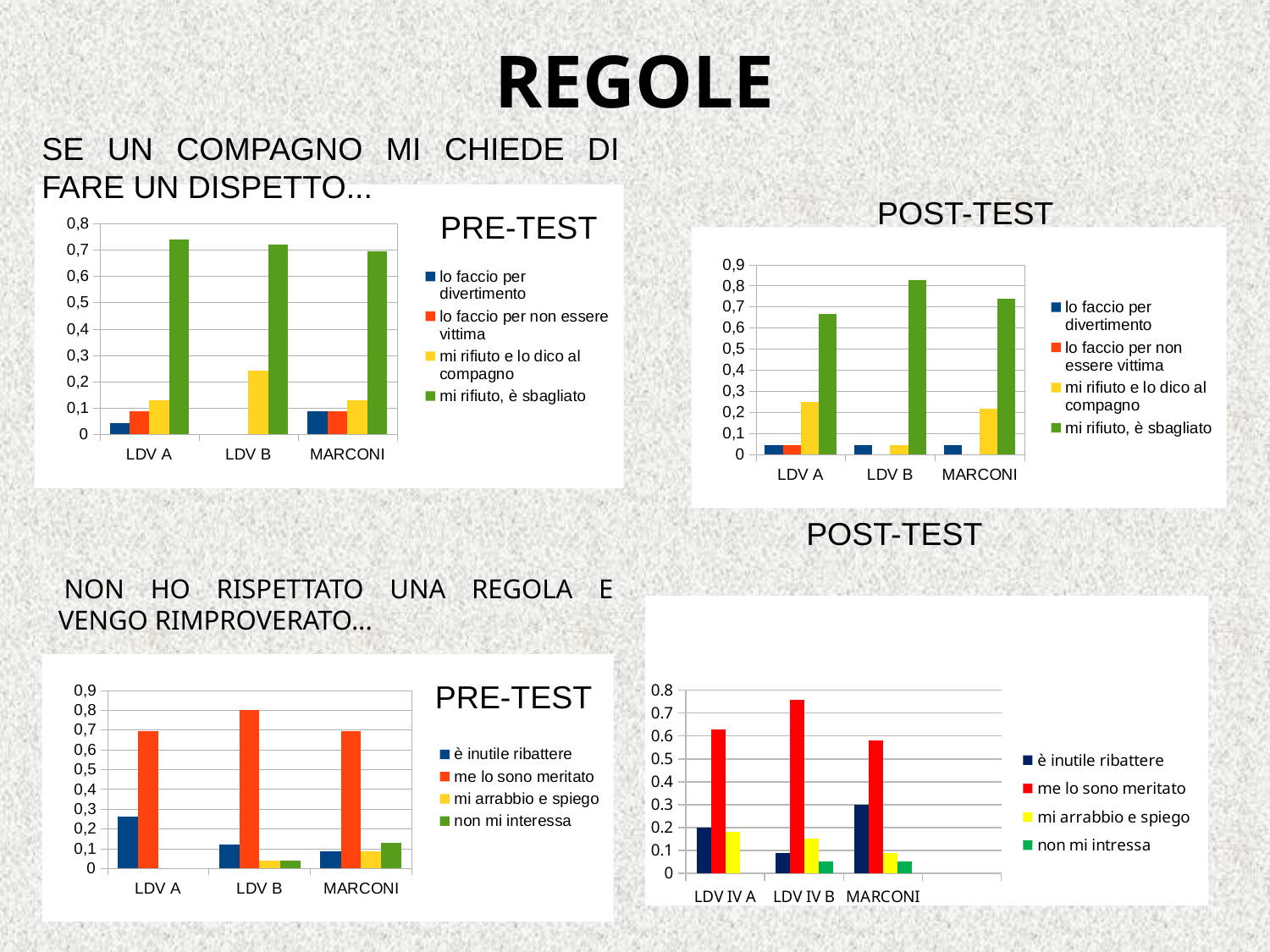
In the POST-TEST chart under "SE UN COMPAGNO MI CHIEDE DI FARE UN DISPETTO...", which category has the highest value for "mi rifiuto, è sbagliato"? LDV B In the PRE-TEST chart under "SE UN COMPAGNO MI CHIEDE DI FARE UN DISPETTO...", how many series does the legend list? 4 In the PRE-TEST chart under "NON HO RISPETTATO UNA REGOLA E VENGO RIMPROVERATO...", is the value of "è inutile ribattere" larger for LDV A or for LDV B? LDV A In the POST-TEST chart under "SE UN COMPAGNO MI CHIEDE DI FARE UN DISPETTO...", is the value of "mi rifiuto, è sbagliato" for LDV B greater or less than 0,7? greater In the PRE-TEST chart under "SE UN COMPAGNO MI CHIEDE DI FARE UN DISPETTO...", is the value of "mi rifiuto e lo dico al compagno" for LDV B greater or less than 0,3? less In the POST-TEST chart at the bottom right of the slide, is the value of "me lo sono meritato" for LDV IV B greater or less than 0.7? greater In the PRE-TEST chart under "SE UN COMPAGNO MI CHIEDE DI FARE UN DISPETTO...", which series has the lowest value for LDV A? lo faccio per divertimento In the PRE-TEST chart under "NON HO RISPETTATO UNA REGOLA E VENGO RIMPROVERATO...", which category has the highest value for "me lo sono meritato"? LDV B In the POST-TEST chart at the bottom right of the slide, how many categories are shown on the x axis? 3 In the POST-TEST chart at the bottom right of the slide, which series has the highest value for LDV IV A? me lo sono meritato In the POST-TEST chart at the bottom right of the slide, what are the three category labels on the x axis? LDV IV A, LDV IV B, MARCONI What kind of chart is the PRE-TEST chart under "SE UN COMPAGNO MI CHIEDE DI FARE UN DISPETTO..."? Bar chart